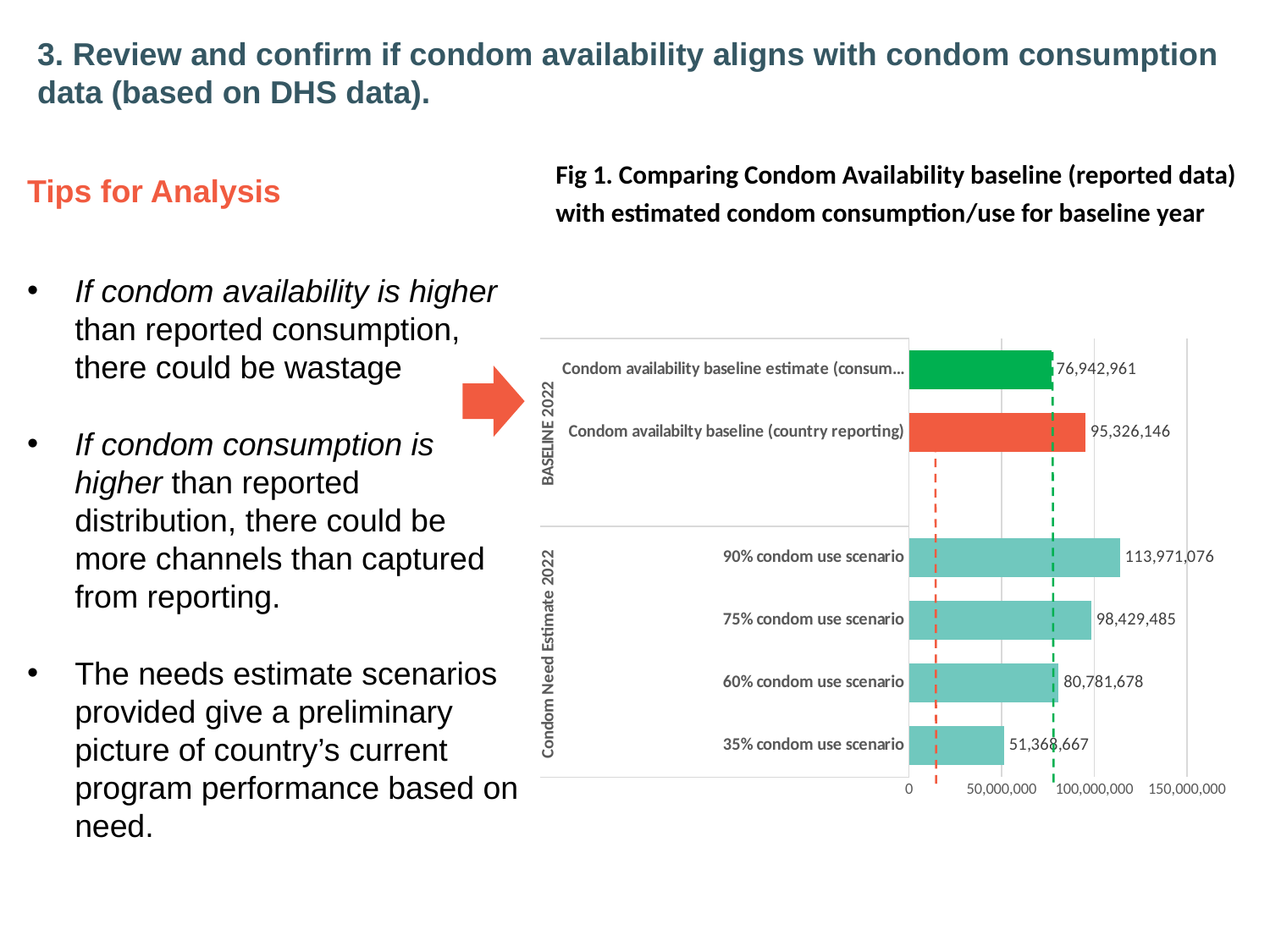
What is the difference between the '90% condom use scenario' and the '75% condom use scenario' values? 15,541,591 How many bars are plotted in the chart? 6 Which bar in the chart has the highest value? 90% condom use scenario Which bar in the chart has the lowest value? 35% condom use scenario Which is larger: the '60% condom use scenario' value or the 'Condom availabilty baseline (country reporting)' value? Condom availabilty baseline (country reporting) What is the value for the '90% condom use scenario' bar? 113,971,076 Is the value for the '35% condom use scenario' greater or less than 100,000,000? less What is the value for the 'Condom availabilty baseline (country reporting)' bar? 95,326,146 What is the value for the '60% condom use scenario' bar? 80,781,678 What is the difference between the 'Condom availabilty baseline (country reporting)' value and the 'Condom availability baseline estimate' value? 18,383,185 What is the value for the '75% condom use scenario' bar? 98,429,485 What kind of chart is shown in Fig 1? Bar chart